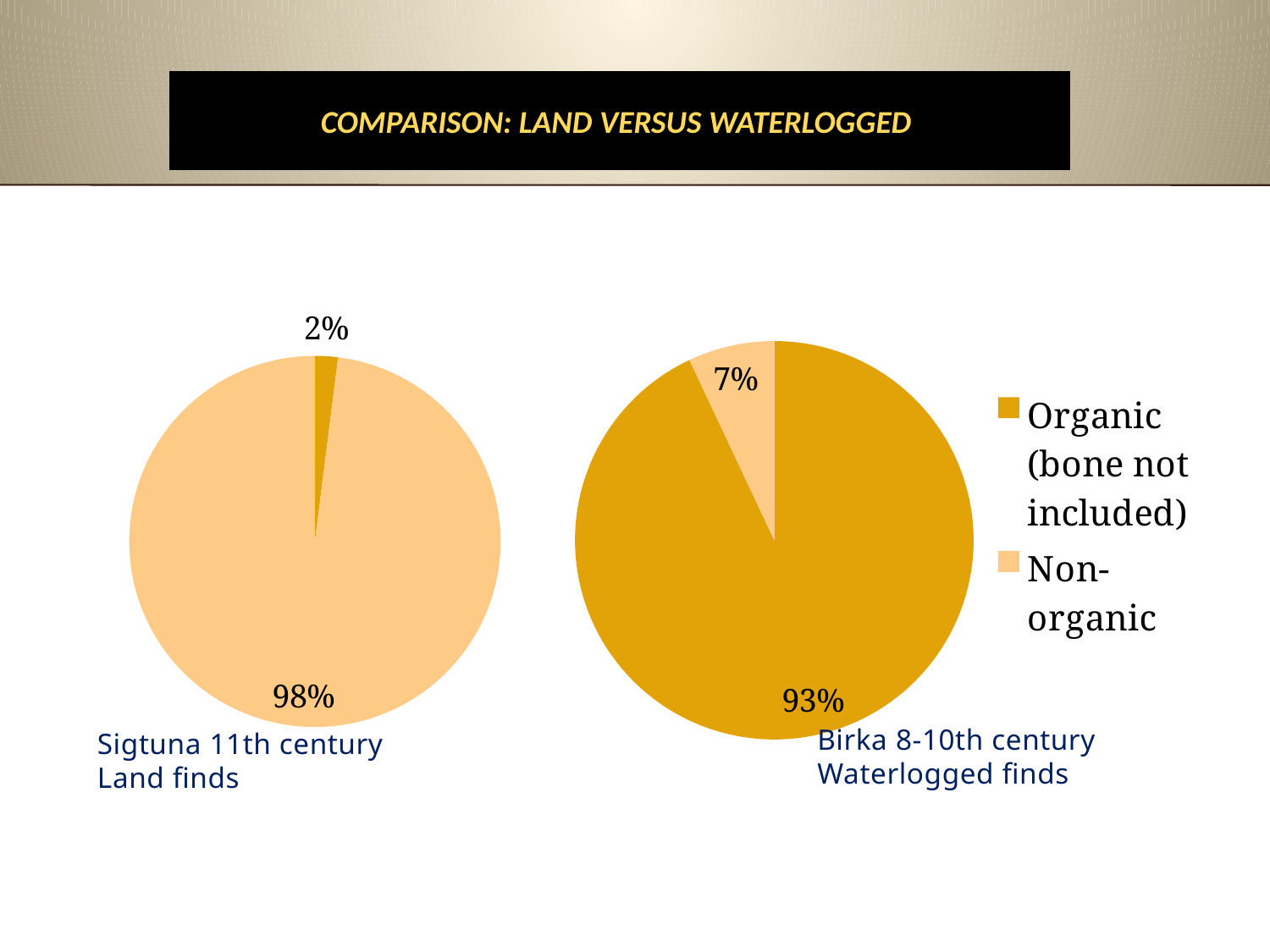
In the Birka 8-10th century Waterlogged finds pie chart, which category has the smallest slice? Non-organic In the Sigtuna 11th century Land finds pie chart, which category has the largest slice? Non-organic Which chart has the larger Non-organic share, the Sigtuna Land finds chart or the Birka Waterlogged finds chart? Sigtuna 11th century Land finds What is the difference between the Organic share in the Birka Waterlogged finds chart and the Organic share in the Sigtuna Land finds chart? 91% How many entries does the legend list? 2 In the Birka 8-10th century Waterlogged finds pie chart, what share is Non-organic? 7% What type of chart is used on this slide? Pie chart In the Birka 8-10th century Waterlogged finds pie chart, what share is Organic (bone not included)? 93% How many slices does the Birka 8-10th century Waterlogged finds pie chart have? 2 In the Sigtuna 11th century Land finds pie chart, what share is Organic (bone not included)? 2% What is the title of the slide containing the two pie charts? COMPARISON: LAND VERSUS WATERLOGGED In the Sigtuna 11th century Land finds pie chart, what share is Non-organic? 98%